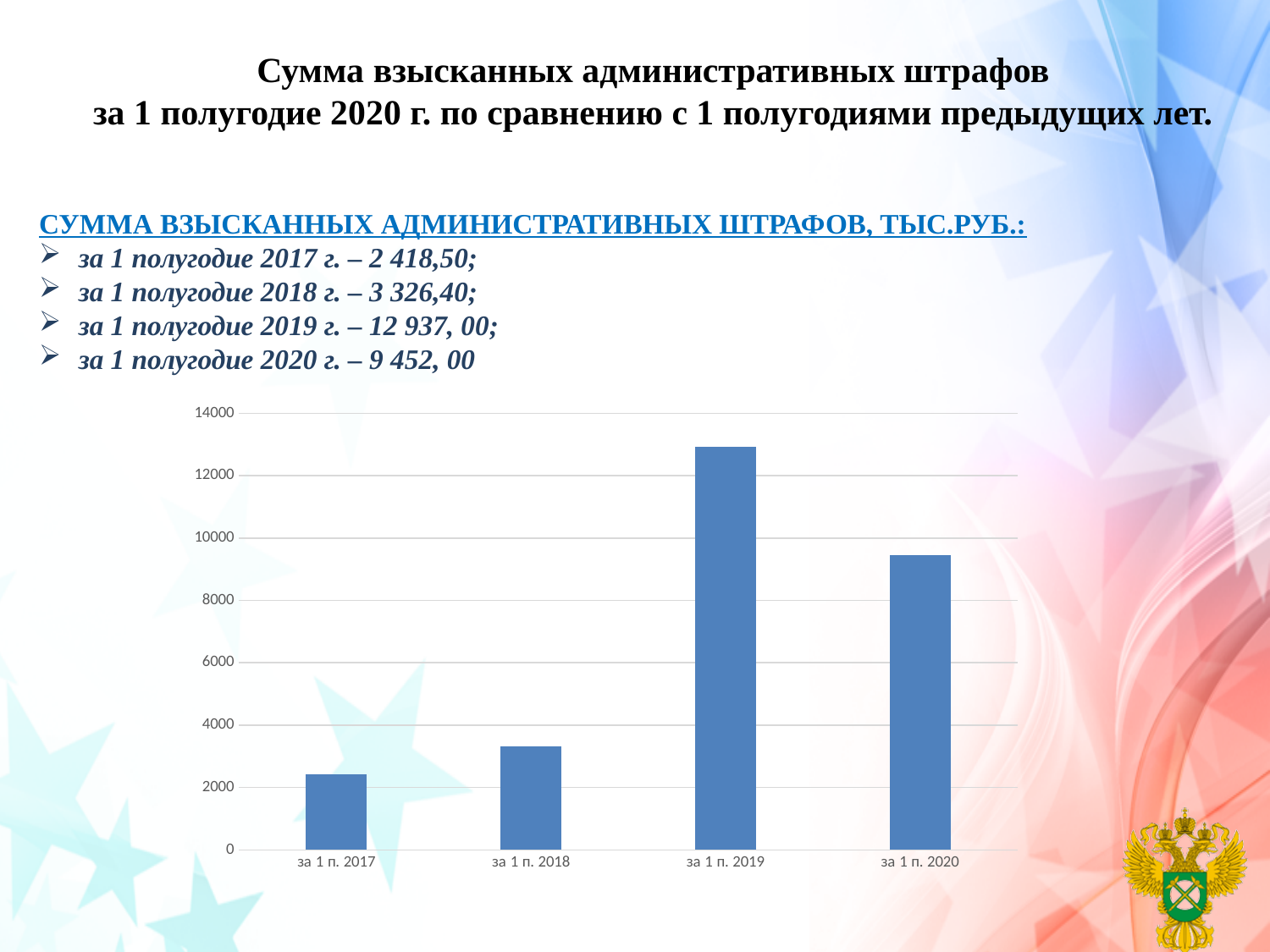
Do the bars rise or fall from за 1 п. 2017 to за 1 п. 2019? rise According to the slide, what is the sum of collected administrative fines (тыс. руб.) for the 1st half of 2019? 12 937, 00 Is the value for за 1 п. 2018 greater or less than 4000? less Which category has the lowest bar in the chart? за 1 п. 2017 What is the highest value shown on the vertical axis of the chart? 14000 Is the value for за 1 п. 2020 greater or less than 10000? less According to the slide, what is the sum of collected administrative fines (тыс. руб.) for the 1st half of 2017? 2 418,50 How many categories (bars) does the chart show? 4 What kind of chart is shown on the slide? bar chart Is the value for за 1 п. 2019 greater or less than 12000? greater Which is larger, the bar for за 1 п. 2020 or the bar for за 1 п. 2018? за 1 п. 2020 Which category has the highest bar in the chart? за 1 п. 2019